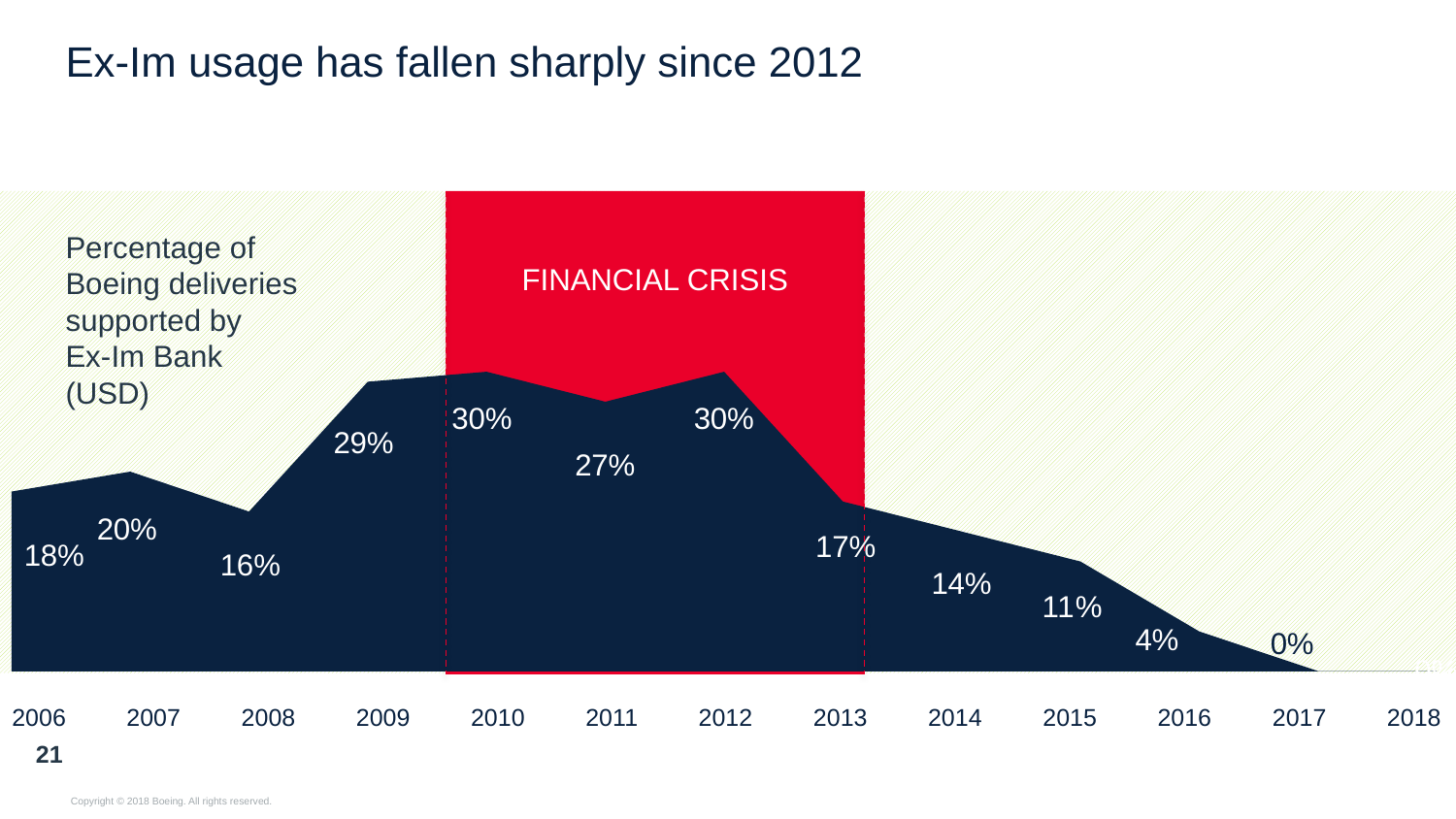
Which year has the larger value, 2014 or 2015? 2014 How many years are shown on the x axis? 13 What is the value shown for 2006? 18% What is the highest percentage value labeled on the chart? 30% Which year has the larger value, 2008 or 2009? 2009 What is the value shown for 2013? 17% By how many percentage points did the value fall from 2012 to 2013? 13 percentage points What kind of chart is shown on the slide? Area chart What is the difference between the 2009 value and the 2008 value? 13 percentage points What percentage of Boeing deliveries was supported by Ex-Im Bank in 2010? 30% Do the values rise or fall from 2012 to 2017? Fall What percentage is shown for 2016? 4%